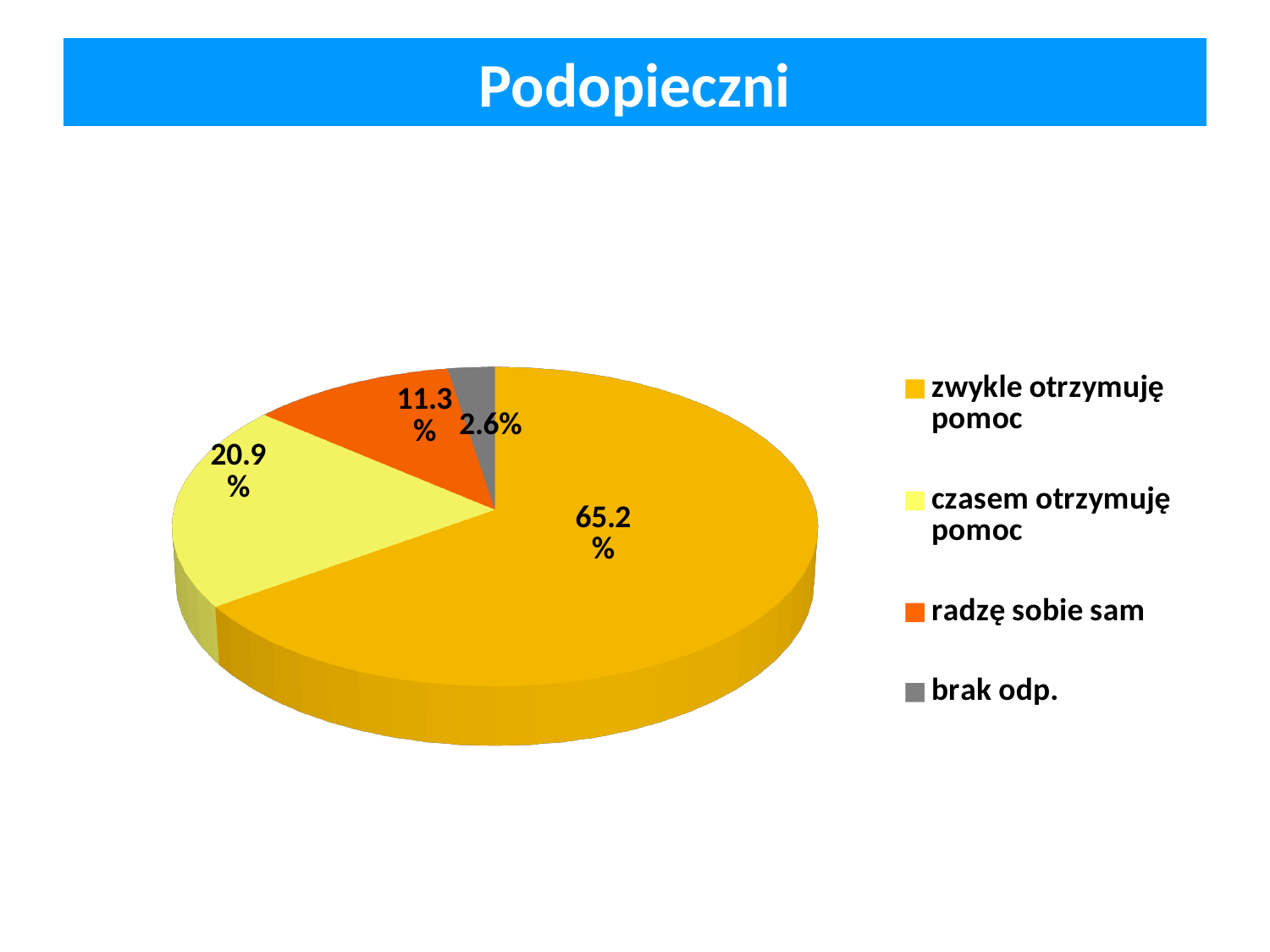
What share of the pie does 'zwykle otrzymuję pomoc' have? 65.2% What is the title of the slide? Podopieczni What colour is the slice for 'radzę sobie sam'? orange What is the difference between the shares of 'zwykle otrzymuję pomoc' and 'czasem otrzymuję pomoc'? 44.3% What type of chart is shown on the slide? pie chart Which is larger: the share for 'radzę sobie sam' or the share for 'brak odp.'? radzę sobie sam How many categories does the pie chart have? 4 What share of the pie does 'czasem otrzymuję pomoc' have? 20.9% Which category has the smallest slice of the pie? brak odp. Which category has the largest slice of the pie? zwykle otrzymuję pomoc What share of the pie does 'brak odp.' have? 2.6% What share of the pie does 'radzę sobie sam' have? 11.3%